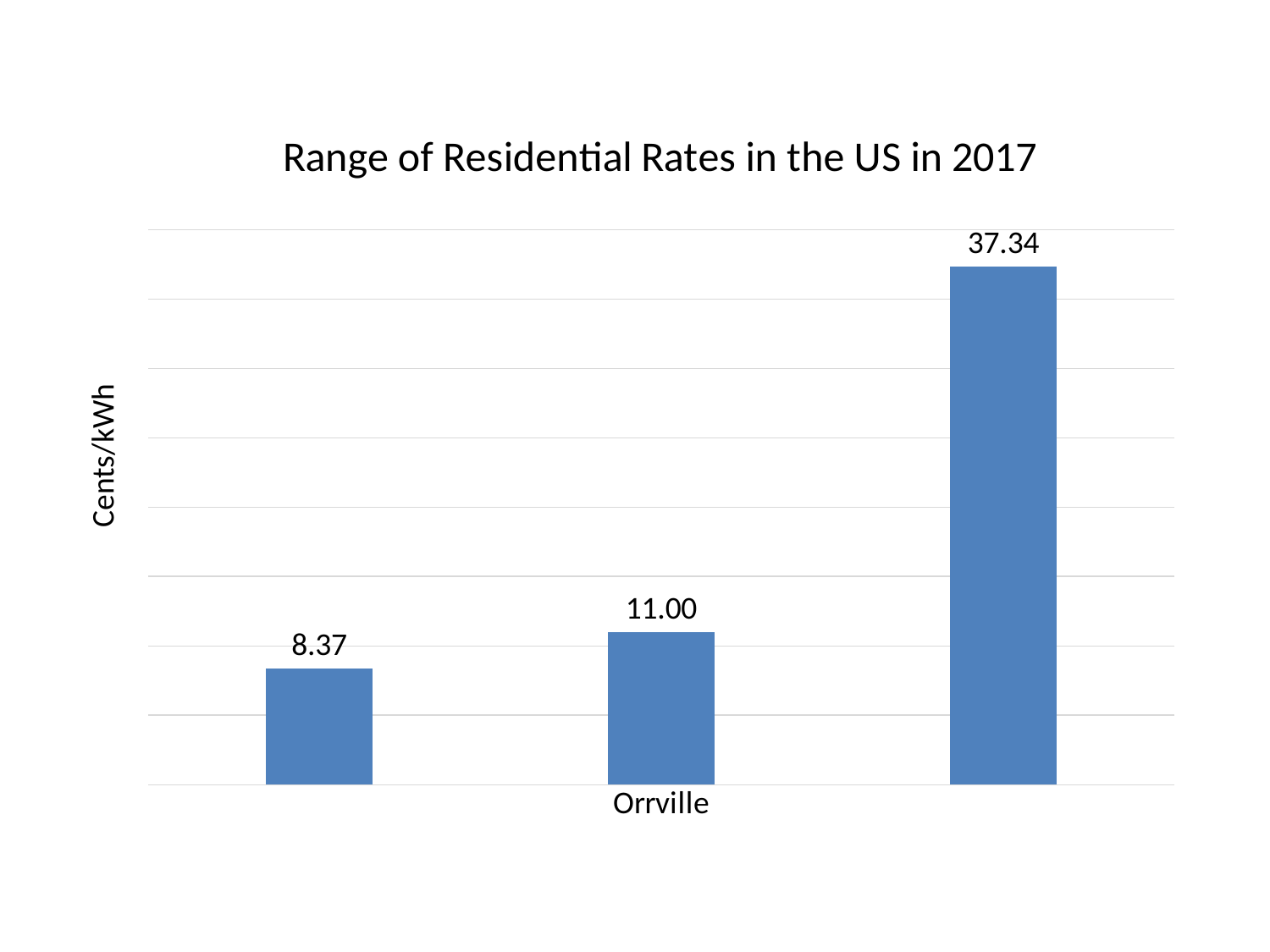
How many bars are plotted on the chart? 3 What is the difference between the highest value on the chart and the value for Orrville? 26.34 What is the value for Orrville? 11.00 What is the label on the vertical axis of the chart? Cents/kWh What kind of chart is shown on the slide? bar chart What is the difference between the value for Orrville and the lowest value on the chart? 2.63 What is the highest value shown on the chart? 37.34 What is the title of the chart? Range of Residential Rates in the US in 2017 What is the lowest value shown on the chart? 8.37 Is the value for Orrville larger or smaller than the highest value on the chart? smaller